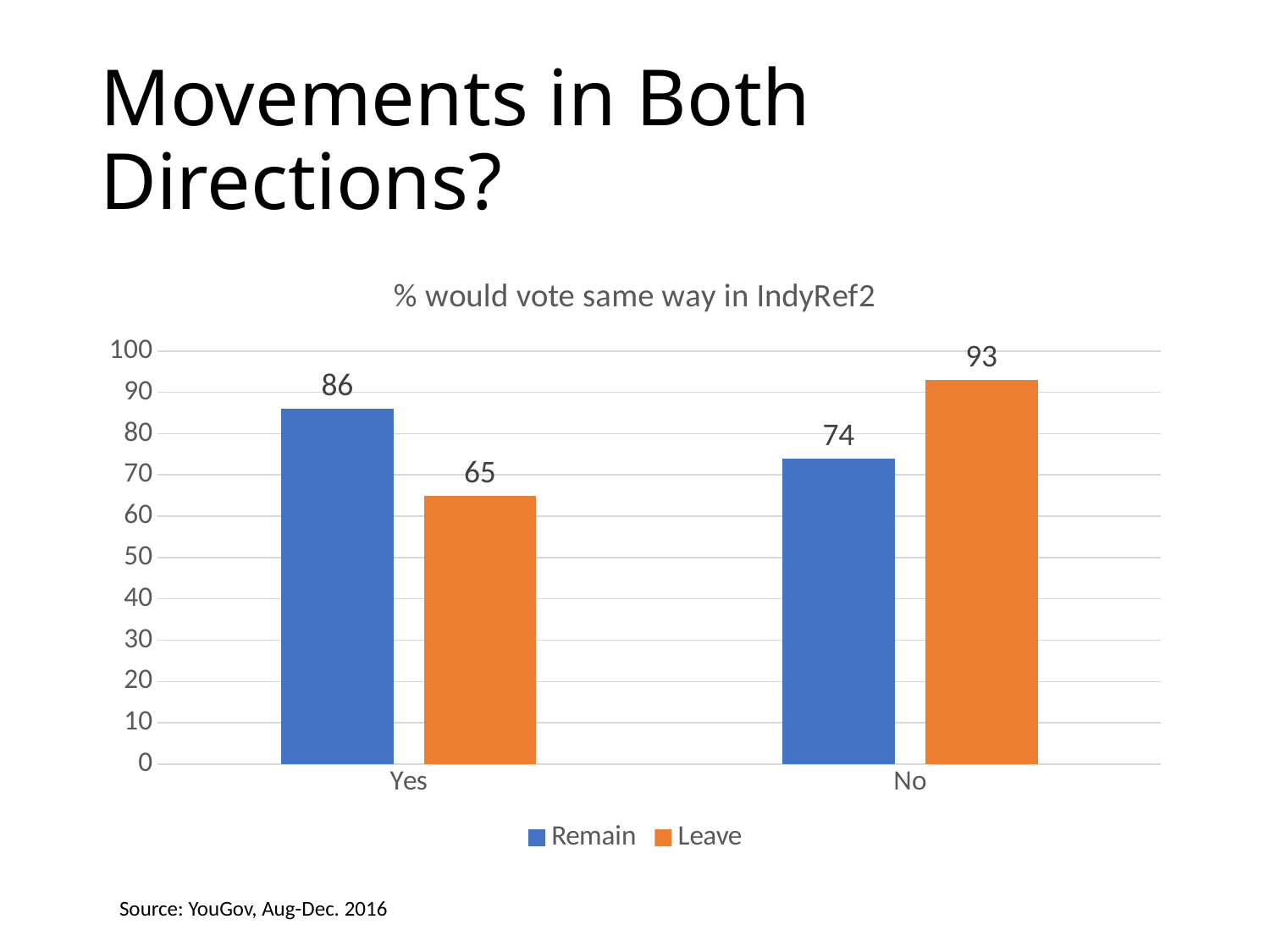
What is the title of the chart? % would vote same way in IndyRef2 Which is larger in the No category, Remain or Leave? Leave What is the value for Leave in the Yes category? 65 What is the difference between the Leave and Remain values in the No category? 19 Which bar has the lowest value on the chart? Leave, Yes What is the difference between the Remain and Leave values in the Yes category? 21 Which bar has the highest value on the chart? Leave, No What is the value for Remain in the Yes category? 86 What kind of chart is shown on the slide? Bar chart How many series does the legend list? 2 What is the value for Remain in the No category? 74 What is the value for Leave in the No category? 93